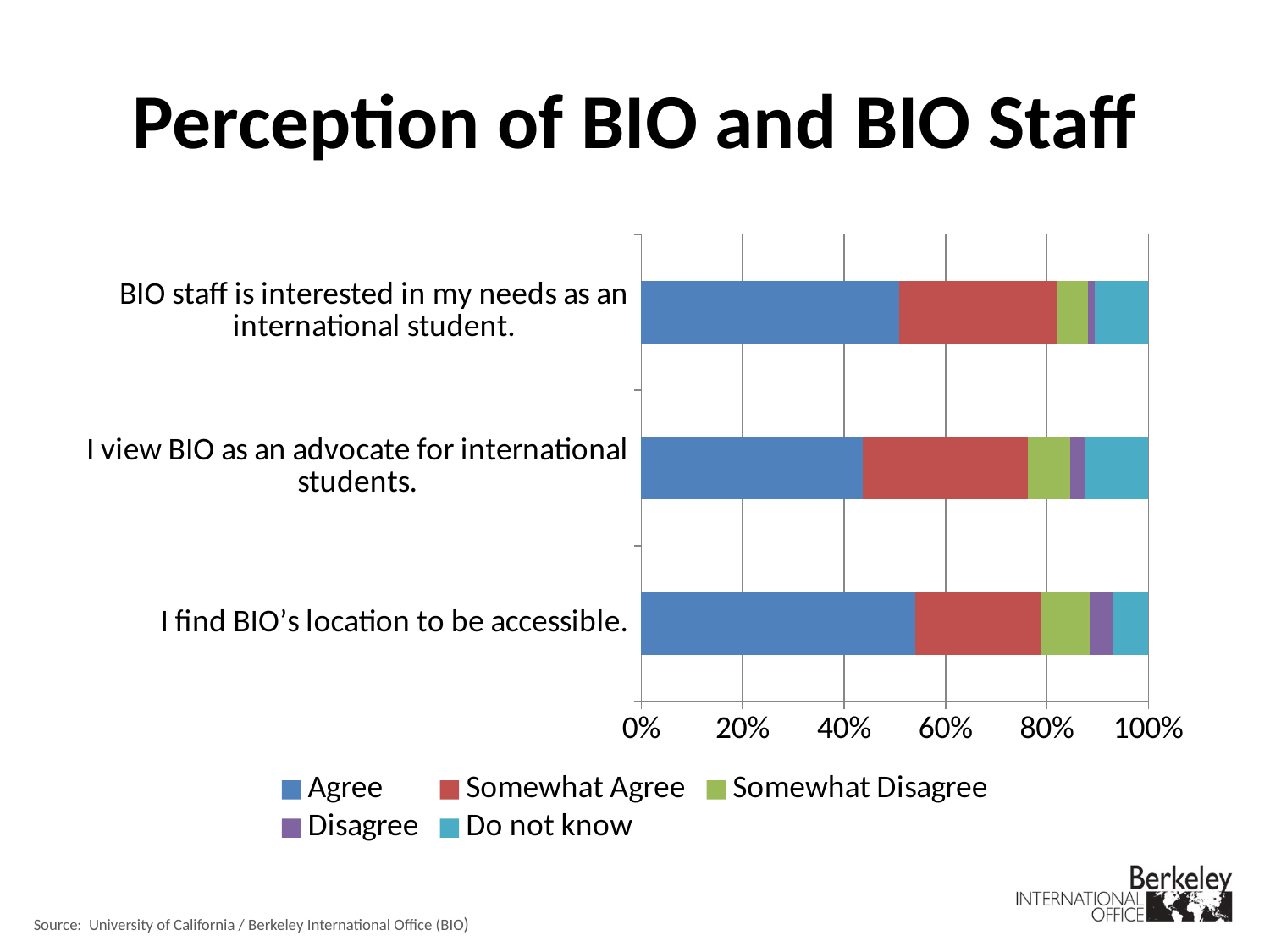
Which statement has the smallest 'Agree' segment? I view BIO as an advocate for international students. Is the 'Agree' value for 'BIO staff is interested in my needs as an international student.' greater or less than 40%? greater What is the total of the stacked bar for 'I find BIO's location to be accessible.'? 100% How many series does the legend list? 5 Which statement has the largest 'Disagree' segment? I find BIO's location to be accessible. Is the 'Agree' value for 'I view BIO as an advocate for international students.' greater or less than 60%? less What is the title of the slide containing the chart? Perception of BIO and BIO Staff How many statements (categories) are plotted in the chart? 3 Is the 'Agree' value for 'I find BIO's location to be accessible.' greater or less than 40%? greater Which statement has the smallest 'Do not know' segment? I find BIO's location to be accessible. Which colour represents the 'Agree' series in the chart? Blue What kind of chart is shown on the slide? Stacked bar chart